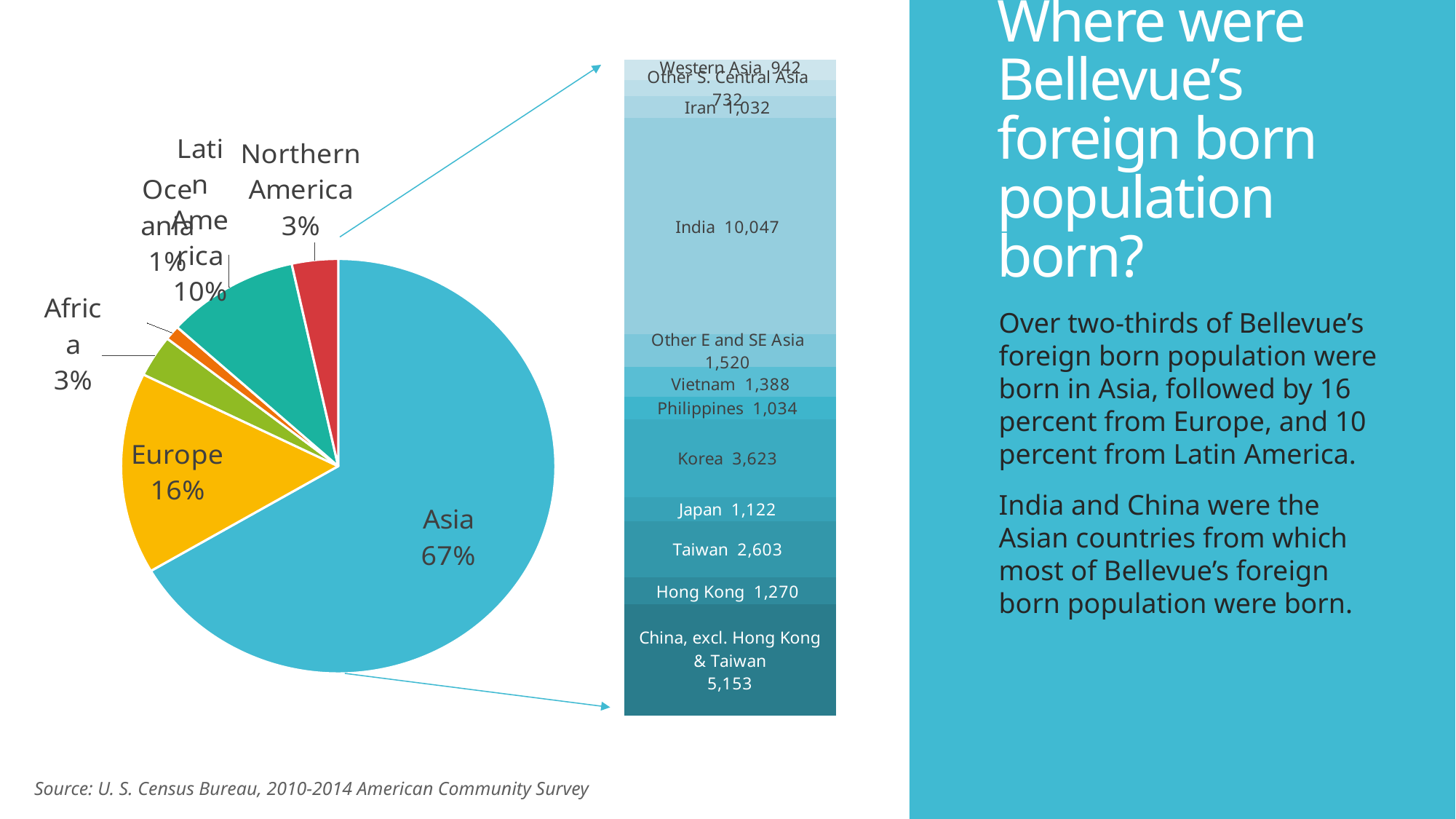
In the stacked bar breakdown of Asia, what is the value for Taiwan? 2,603 In the stacked bar breakdown of Asia, what is the value for Korea? 3,623 In the stacked bar breakdown of Asia, which is larger, the value for Vietnam or the value for Japan? Vietnam In the pie chart, what percentage is shown for Northern America? 3% In the stacked bar breakdown of Asia, which country has the highest value? India In the stacked bar breakdown of Asia, which segment has the lowest value? Other S. Central Asia In the pie chart, what share of Bellevue's foreign born population was born in Europe? 16% In the stacked bar breakdown of Asia, what is the value for India? 10,047 In the stacked bar breakdown of Asia, what is the difference between the values for India and China, excl. Hong Kong & Taiwan? 4,894 In the pie chart, what share of Bellevue's foreign born population was born in Asia? 67% Which region has the largest slice in the pie chart? Asia In the stacked bar breakdown of Asia, what is the value for China, excl. Hong Kong & Taiwan? 5,153